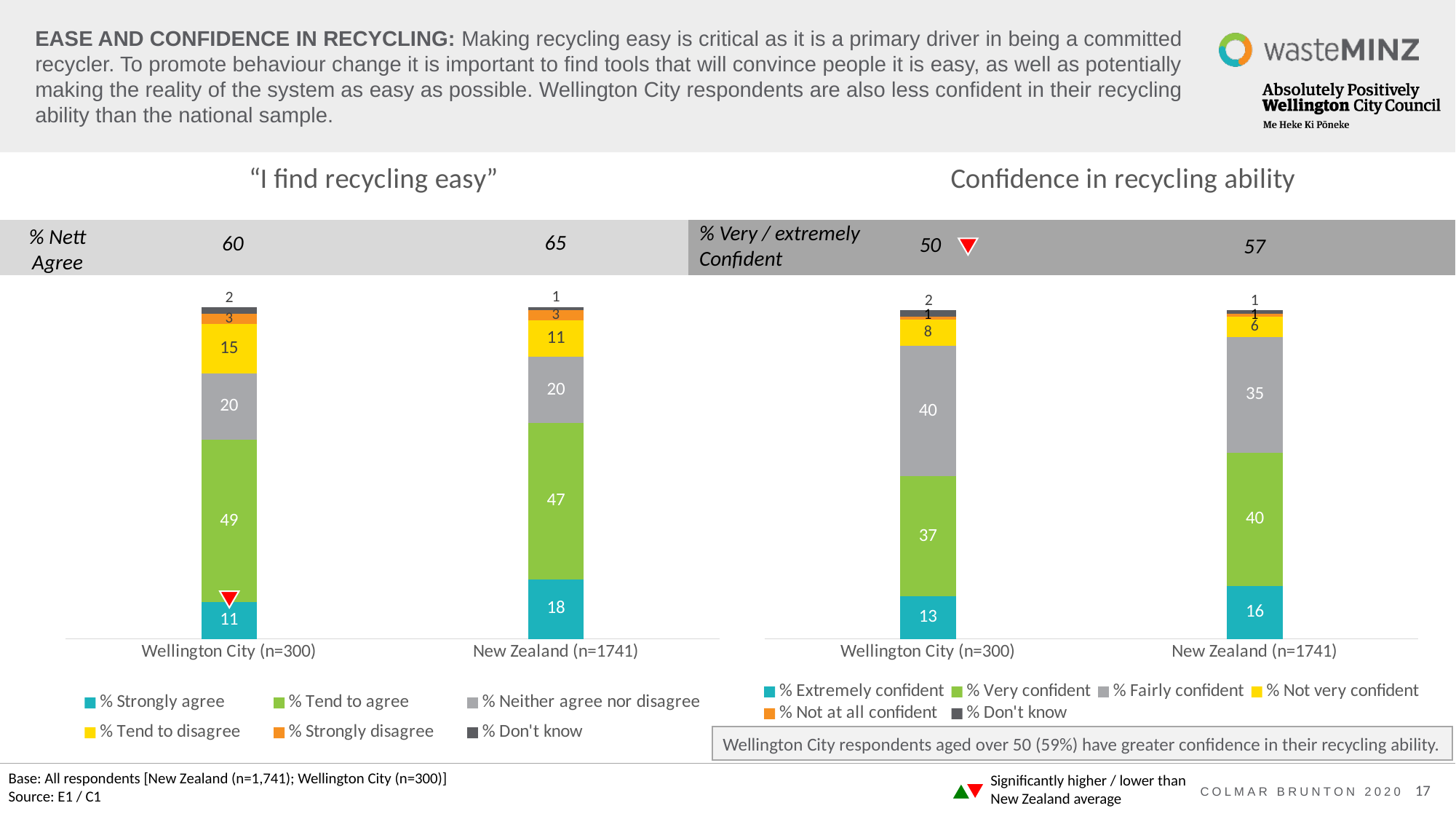
In the Confidence in recycling ability chart, what is the % Fairly confident value for Wellington City (n=300)? 40 In the Confidence in recycling ability chart, which segment is the smallest in the New Zealand (n=1741) bar? % Not at all confident and % Don't know (both 1) In the Confidence in recycling ability chart, what is the % Extremely confident value for New Zealand (n=1741)? 16 In the Confidence in recycling ability chart, which has the larger % Very confident value, Wellington City (n=300) or New Zealand (n=1741)? New Zealand (n=1741) How many bars are shown in the "I find recycling easy" chart? 2 In the "I find recycling easy" chart, what is the difference between the % Strongly agree values for New Zealand (n=1741) and Wellington City (n=300)? 7 What is the % Nett Agree value shown for New Zealand in the "I find recycling easy" chart? 65 In the "I find recycling easy" chart, what is the % Strongly agree value for Wellington City (n=300)? 11 In the "I find recycling easy" chart, which segment is the largest in the Wellington City (n=300) bar? % Tend to agree In the "I find recycling easy" chart, what is the % Tend to agree value for New Zealand (n=1741)? 47 What kind of chart is the "I find recycling easy" chart? Stacked bar chart How many series does the legend of the Confidence in recycling ability chart list? 6